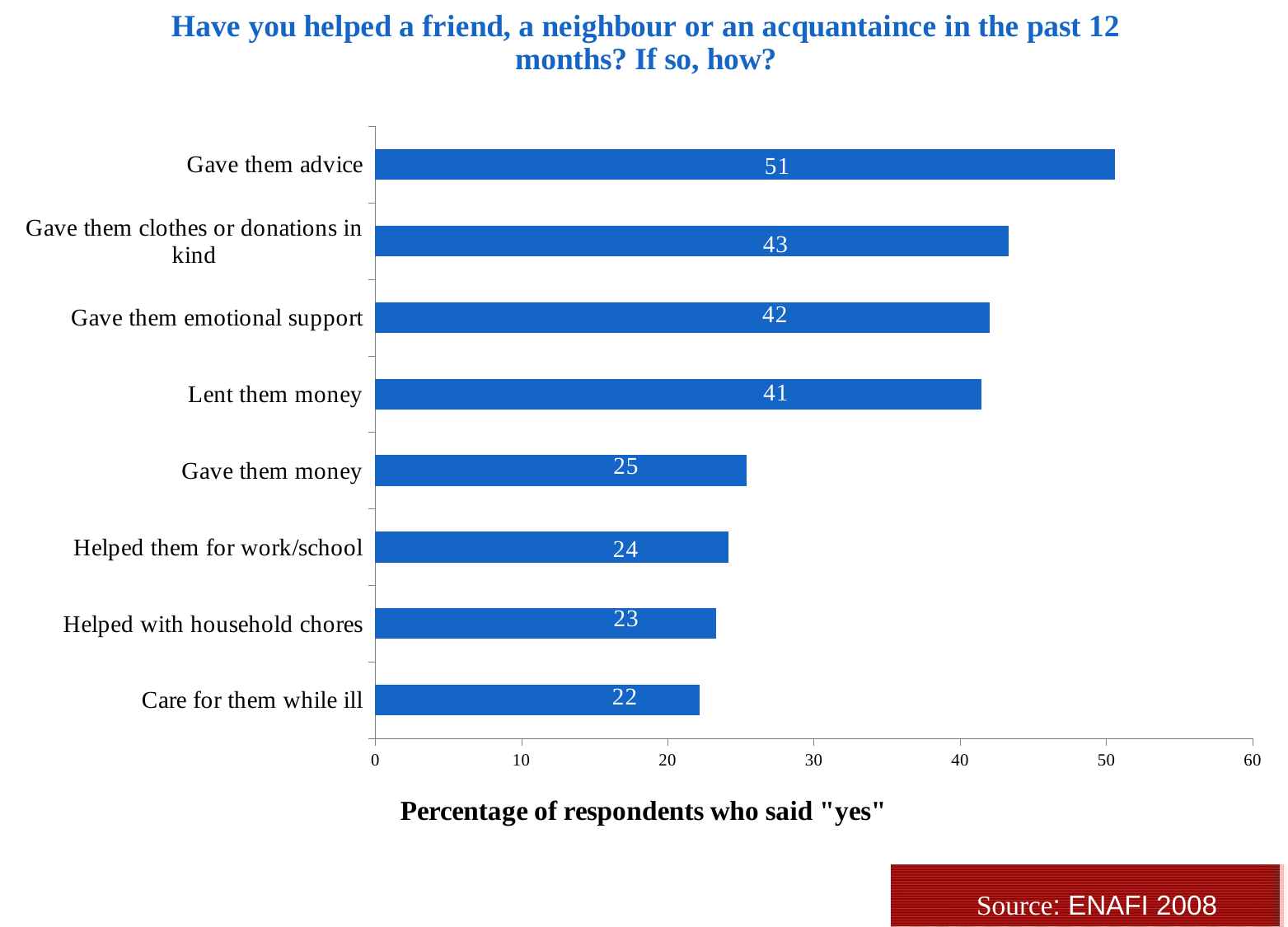
What is the value for "Lent them money"? 41 What percentage of respondents said they gave them advice? 51 How many categories are shown in the chart? 8 Which category has the lowest value? Care for them while ill What is the difference between the values for "Gave them advice" and "Gave them money"? 26 What is the label of the horizontal axis? Percentage of respondents who said "yes" What is the value for "Care for them while ill"? 22 What is the difference between "Gave them clothes or donations in kind" and "Helped with household chores"? 20 What kind of chart is shown on the slide? Bar chart Which category has the highest value? Gave them advice Which is larger: the value for "Gave them emotional support" or "Helped them for work/school"? Gave them emotional support Is the value for "Gave them clothes or donations in kind" greater or less than 40? greater